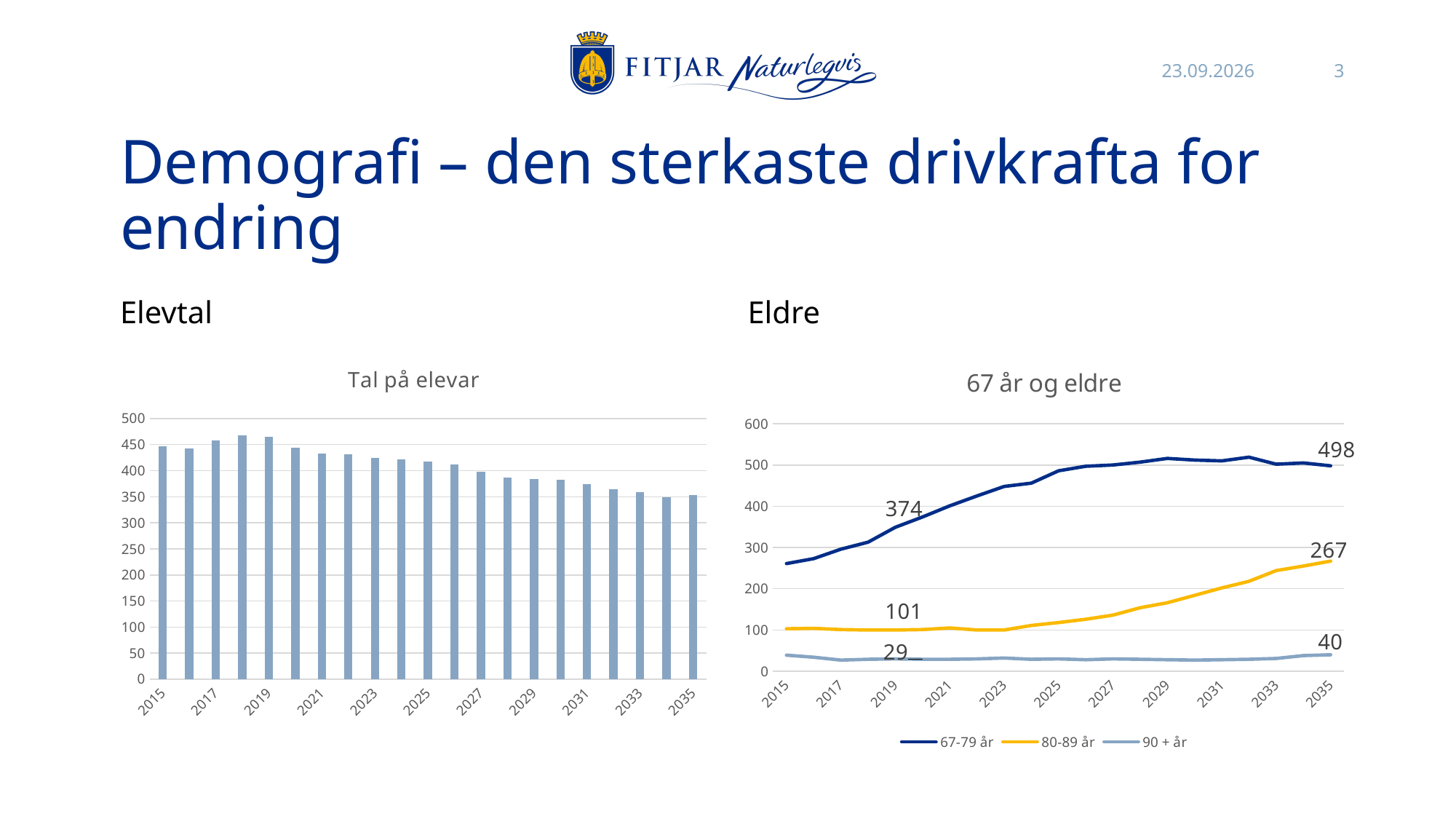
In the chart titled "67 år og eldre", what is the value for the 67-79 år series in 2035? 498 In the chart titled "Tal på elevar", do the values rise or fall from 2019 to 2035? fall In the chart titled "67 år og eldre", what is the value for the 80-89 år series in 2035? 267 In the chart titled "Tal på elevar", is the value for 2035 greater or less than 400? less In the chart titled "67 år og eldre", which series has the highest value in 2035? 67-79 år What kind of chart is the chart titled "Tal på elevar"? bar chart In the chart titled "Tal på elevar", is the value for 2015 greater or less than 400? greater How many series does the legend of the chart titled "67 år og eldre" list? 3